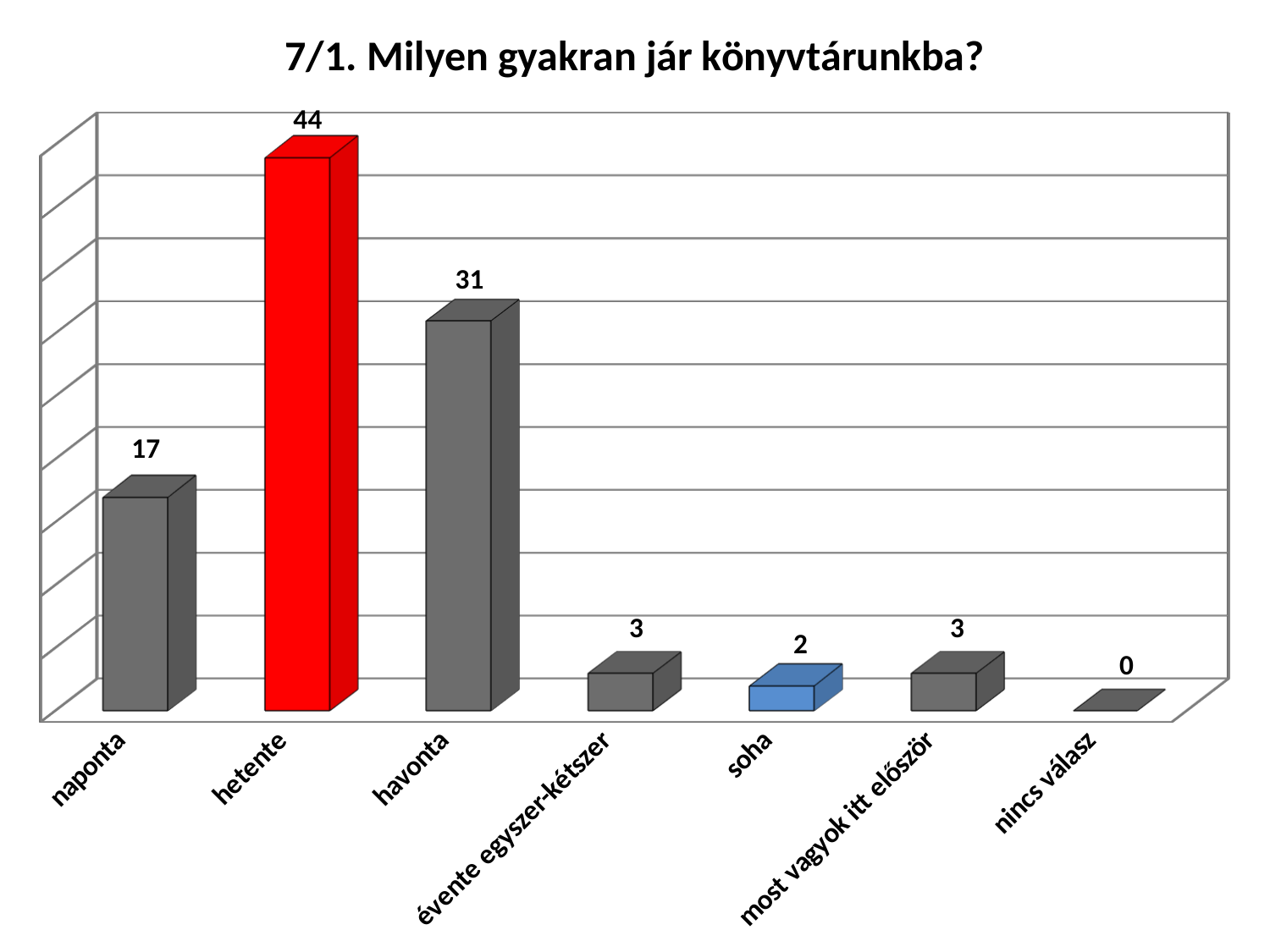
What colour is the bar for "hetente"? red Which category has the lowest value? nincs válasz Which is larger, the value for "naponta" or the value for "havonta"? havonta What is the value for "soha"? 2 What is the value for "naponta"? 17 What kind of chart is this? bar chart Which category has the highest value? hetente What is the value for "havonta"? 31 How many categories are shown on the x axis? 7 What is the value for "hetente"? 44 What is the value for "nincs válasz"? 0 What is the difference between the values for "hetente" and "havonta"? 13